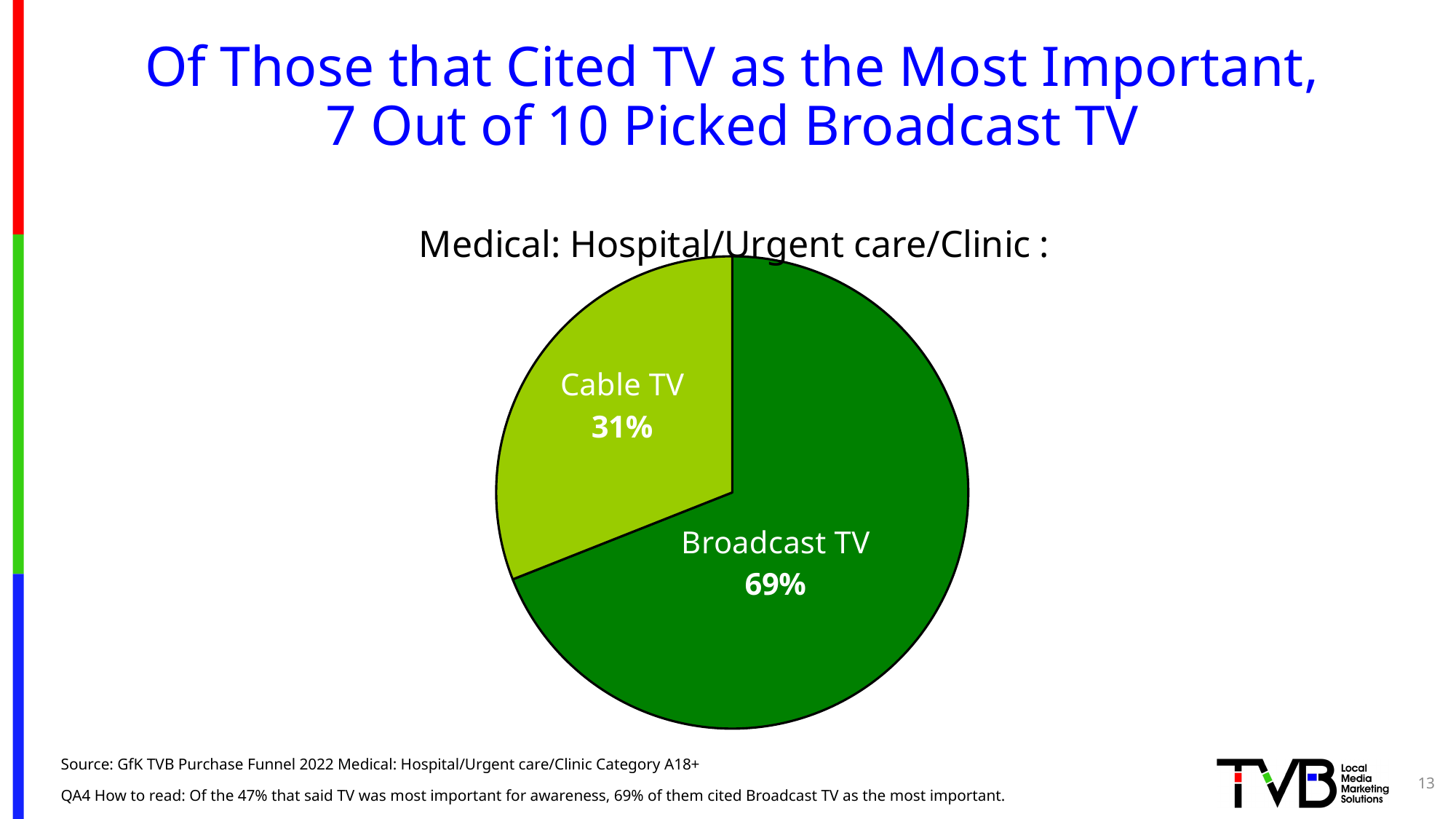
Is the value for Cable TV greater or less than 50%? less What kind of chart is shown on the slide? Pie chart What share of the pie does Cable TV hold? 31% What is the difference in percentage points between the Broadcast TV and Cable TV slices? 38 Which slice is shown in the lighter green colour? Cable TV Which slice of the pie is the smallest? Cable TV Which is larger, the Cable TV slice or the Broadcast TV slice? Broadcast TV What share of the pie does Broadcast TV hold? 69% How many slices does the pie chart have? 2 Which slice of the pie is the largest? Broadcast TV What is the title of the chart? Medical: Hospital/Urgent care/Clinic :